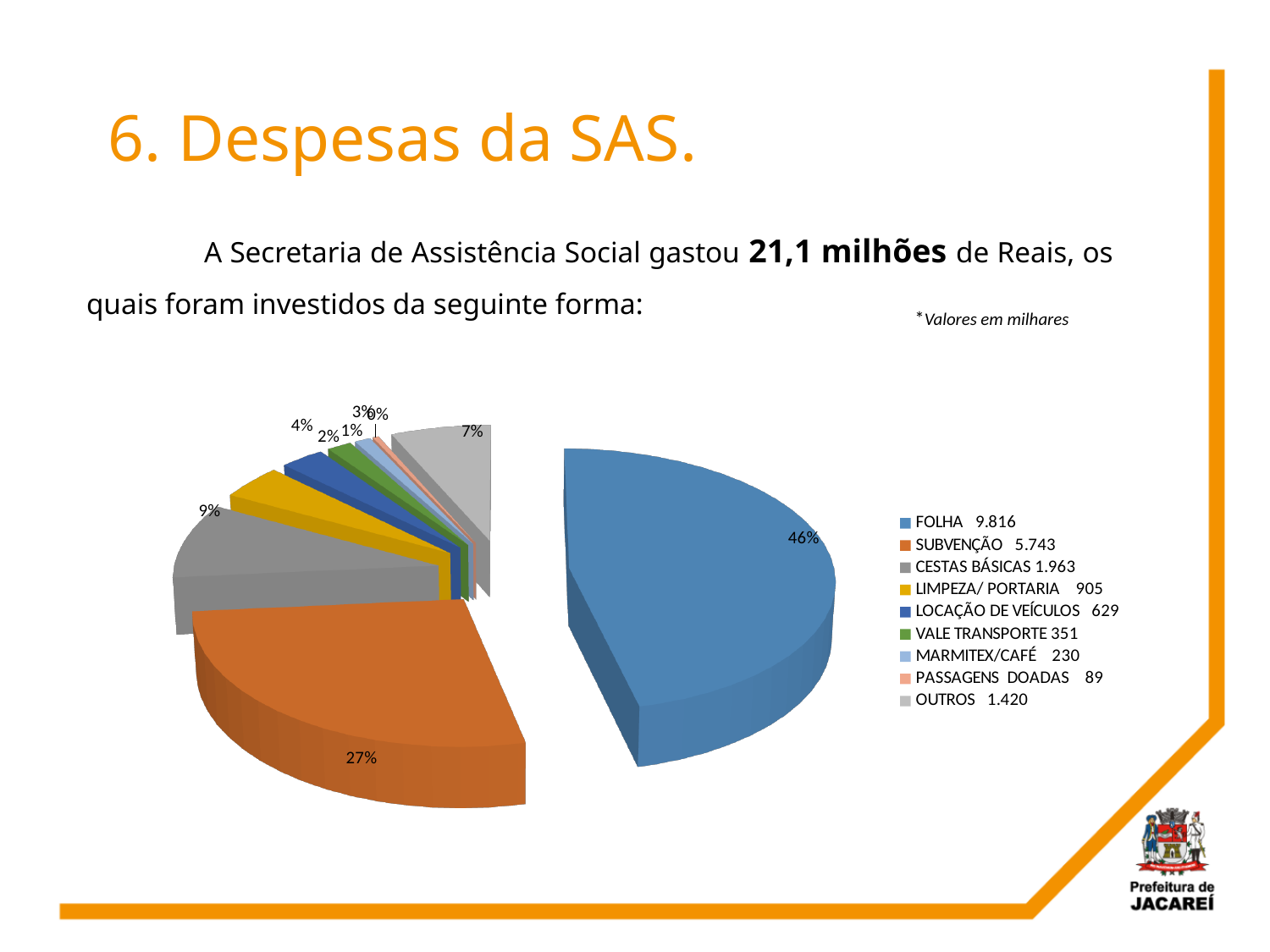
What kind of chart is shown on the slide? pie chart What value is shown in the legend for OUTROS? 1.420 What value is shown in the legend for SUBVENÇÃO? 5.743 Which is larger, the value for CESTAS BÁSICAS or the value for OUTROS? CESTAS BÁSICAS Which category has the largest slice of the pie chart? FOLHA Which category has the smallest slice of the pie chart? PASSAGENS DOADAS What value is shown in the legend for VALE TRANSPORTE? 351 What share of the pie does the SUBVENÇÃO slice represent? 27% How many categories does the pie chart's legend list? 9 What value is shown in the legend for FOLHA? 9.816 What is the difference between the legend values for FOLHA and SUBVENÇÃO? 4.073 What share of the pie does the FOLHA slice represent? 46%